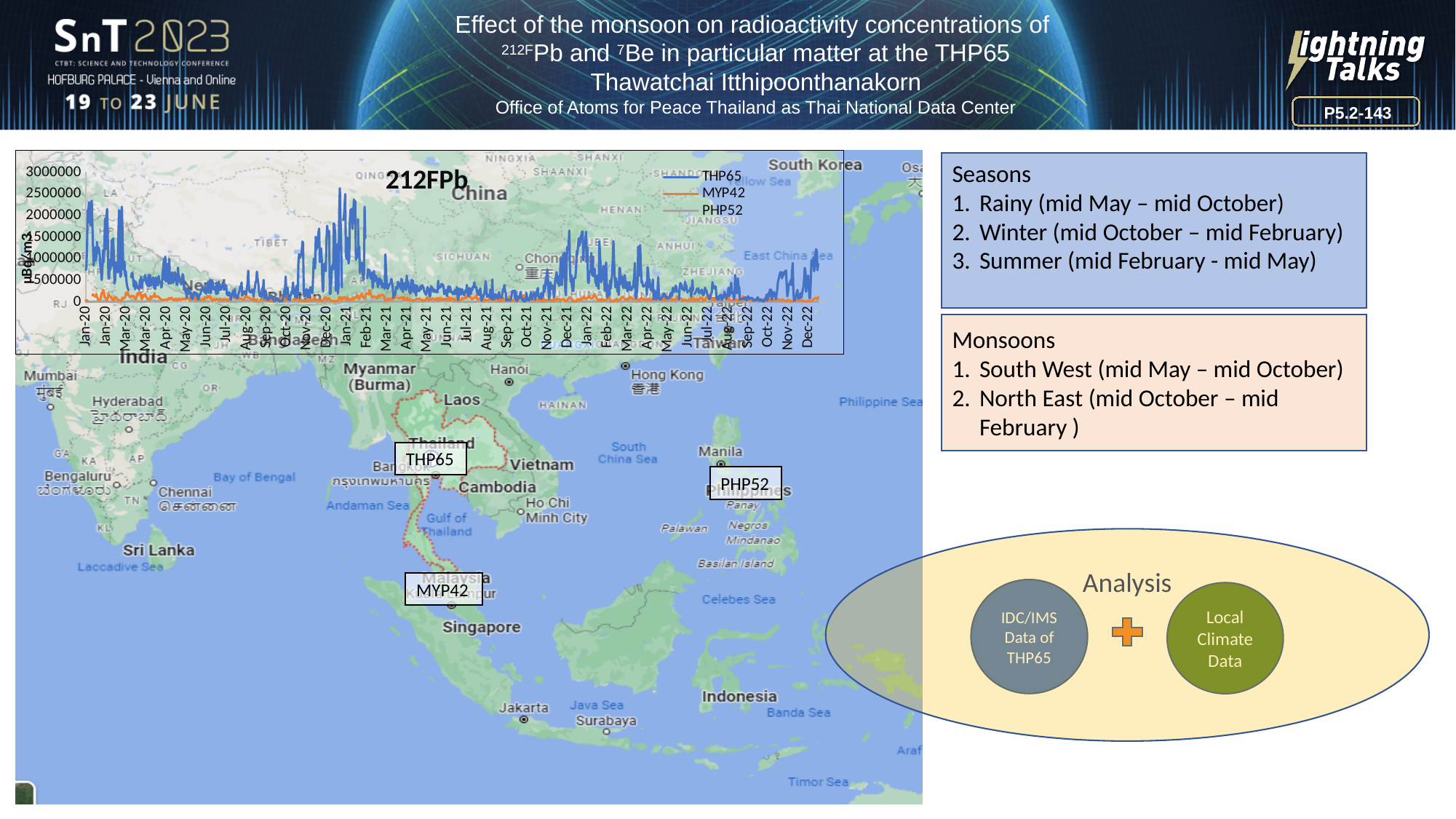
What is the title of the chart? 212FPb Which series has the larger value in Dec-20, THP65 or MYP42? THP65 Is the value for MYP42 in Jan-21 greater or less than 500000? less Which series are listed in the chart legend? THP65, MYP42, PHP52 How many series does the chart legend list? 3 Is the highest peak of the THP65 series greater or less than 2000000? greater Is the value for MYP42 in Dec-22 greater or less than 1000000? less Which series has the larger value in Jan-21, THP65 or MYP42? THP65 What kind of chart is shown on the slide? line chart Which series reaches the highest values on the chart? THP65 What is the maximum value shown on the chart's vertical axis? 3000000